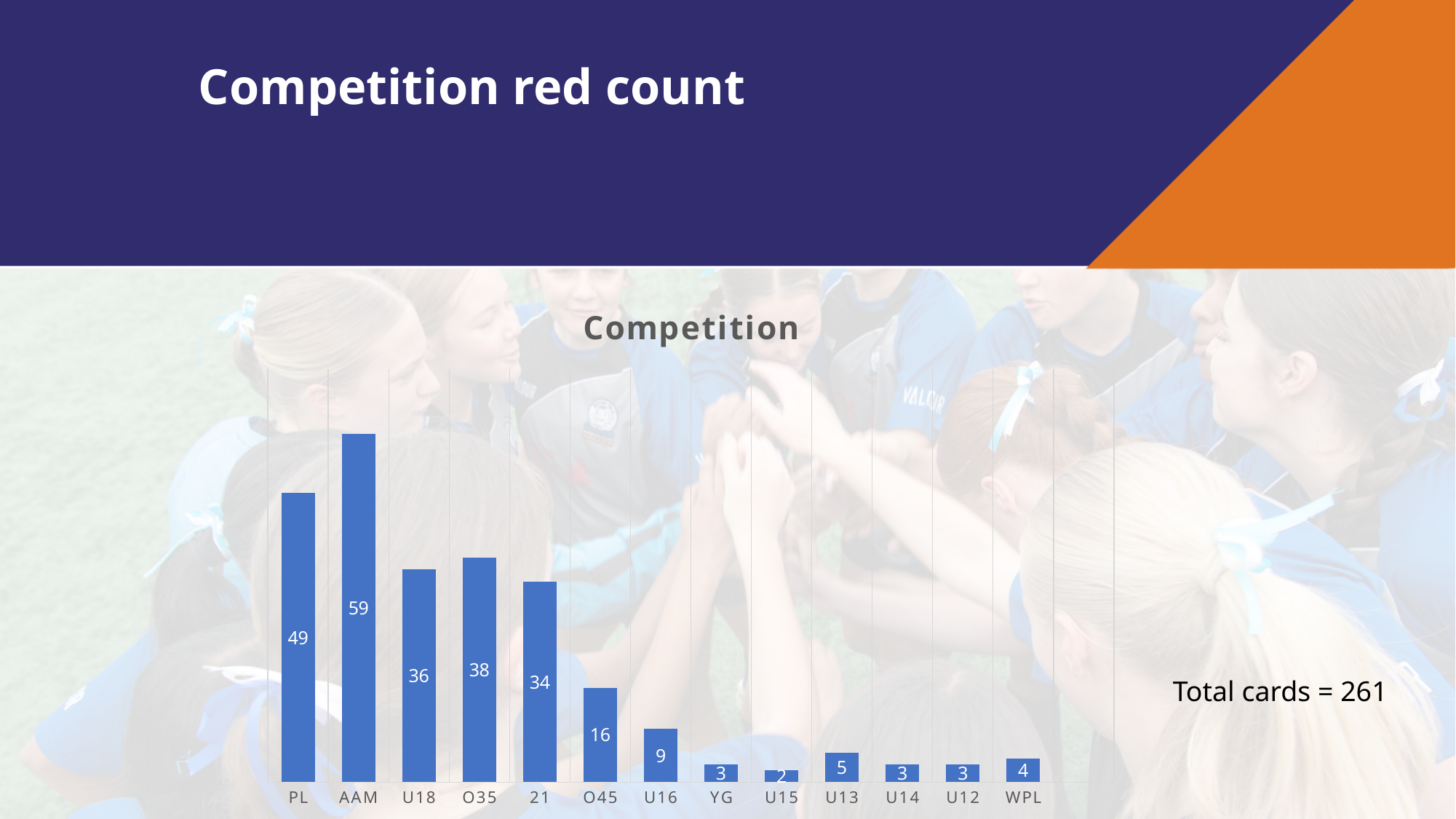
What is the value for O45? 16 Which is larger, the value for 21 or the value for U16? 21 What is the value for AAM? 59 What kind of chart is shown on the slide? bar chart What is the difference between the values for AAM and PL? 10 Which competition has the highest red count? AAM What is the title of the chart? Competition How many competitions are shown on the x axis? 13 Which is larger, the value for O35 or the value for U18? O35 What is the difference between the values for O35 and U18? 2 Which competition has the lowest red count? U15 What is the value for U13? 5